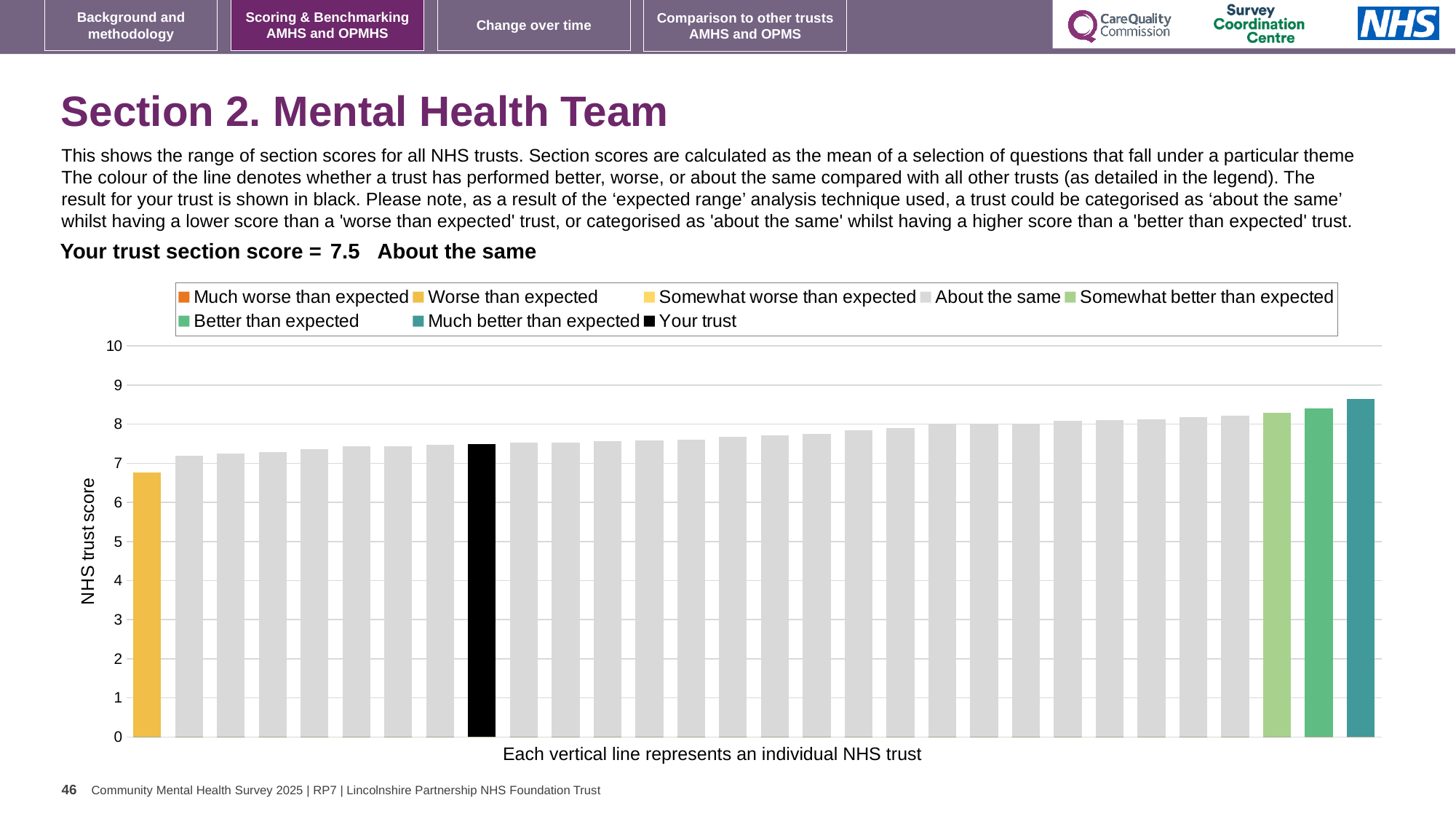
How many entries does the chart legend list? 8 Is the value of the rightmost (teal, 'Much better than expected') bar greater or less than 8? greater What kind of chart is shown on the slide? bar chart Which legend category does the shortest bar belong to? Worse than expected Which legend category does the tallest bar belong to? Much better than expected Which is taller: the black 'Your trust' bar or the yellow 'Worse than expected' bar? the black 'Your trust' bar Do the bar values rise or fall from left to right along the x axis? rise How many bars are coloured yellow ('Worse than expected')? 1 What is the section score for your trust (the black bar)? 7.5 What is the label on the vertical axis of the chart? NHS trust score Is the value of the black 'Your trust' bar greater or less than 7? greater Is the value of the leftmost (yellow, 'Worse than expected') bar greater or less than 7? less